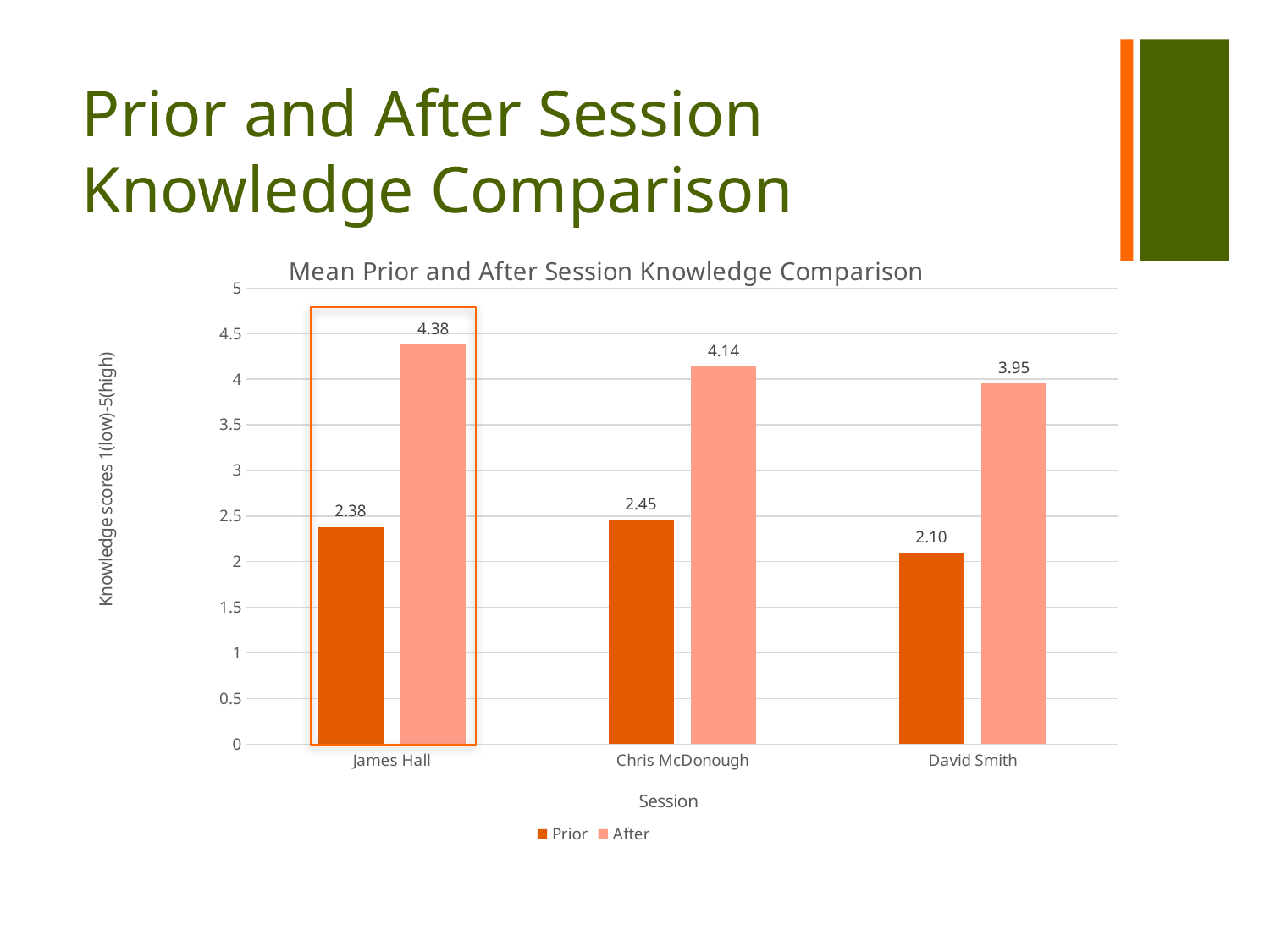
What is the difference between the Prior scores for Chris McDonough and David Smith? 0.35 What is the After knowledge score for David Smith? 3.95 What is the title of the chart? Mean Prior and After Session Knowledge Comparison What is the difference between the After and Prior scores for James Hall? 2.00 What kind of chart is shown on the slide? Bar chart How many series does the legend list? 2 Which is larger, the After score for Chris McDonough or the After score for David Smith? Chris McDonough Which session has the highest After score? James Hall How many sessions are shown on the x axis? 3 Which session has the lowest Prior score? David Smith What is the After knowledge score for Chris McDonough? 4.14 What is the Prior knowledge score for James Hall? 2.38